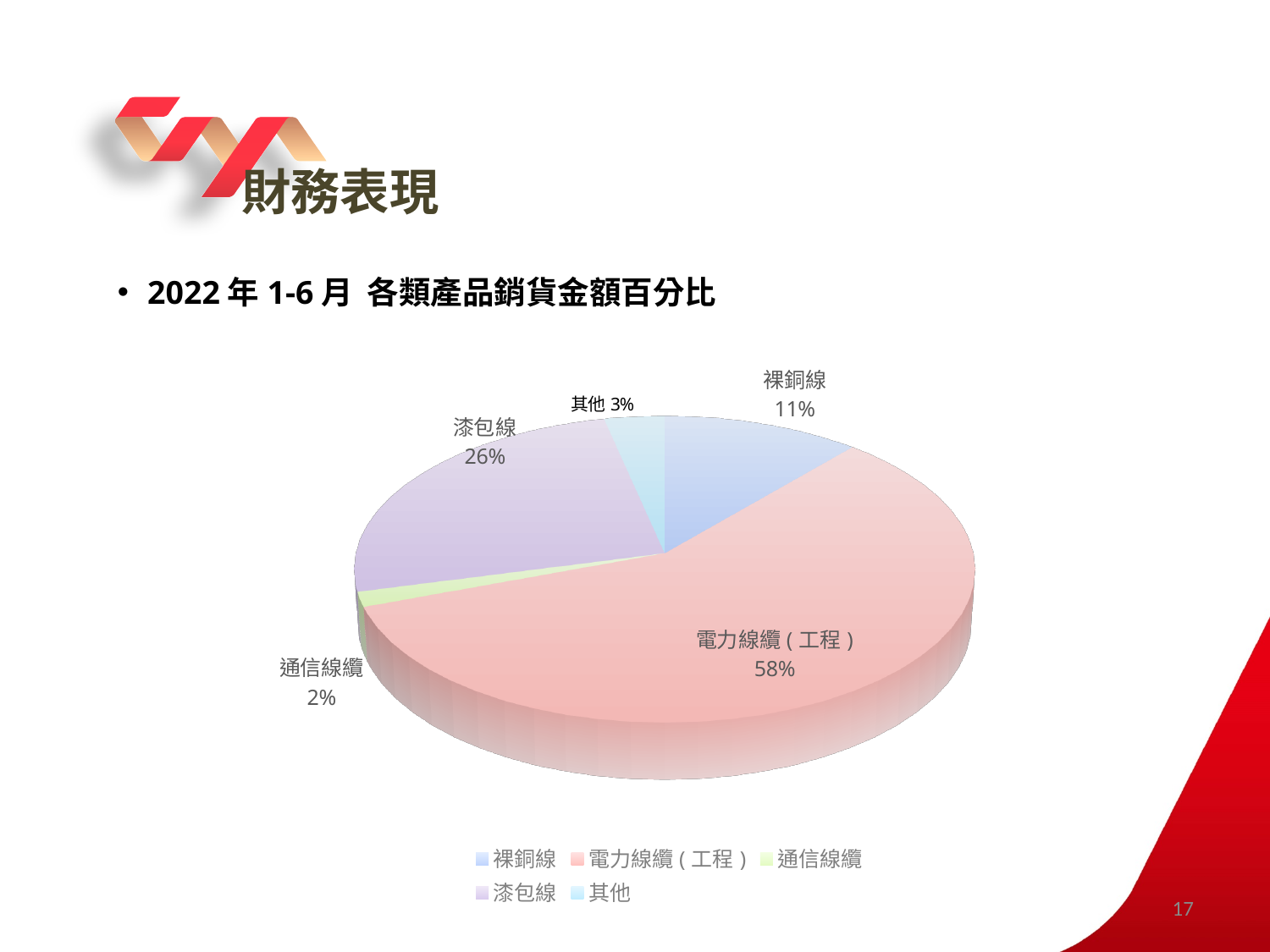
What kind of chart is shown on the slide? Pie chart What share of sales does 裸銅線 account for? 11% How many product categories are shown in the pie chart? 5 What share of sales does 電力線纜(工程) account for? 58% What share of sales does 漆包線 account for? 26% What period does the chart title say the sales percentages cover? 2022年1-6月 Which product category has the largest share of sales? 電力線纜(工程) What is the difference in percentage points between 電力線纜(工程) and 漆包線? 32 Which has a larger share, 裸銅線 or 其他? 裸銅線 What share of sales does 其他 account for? 3% What share of sales does 通信線纜 account for? 2% Which product category has the smallest share of sales? 通信線纜